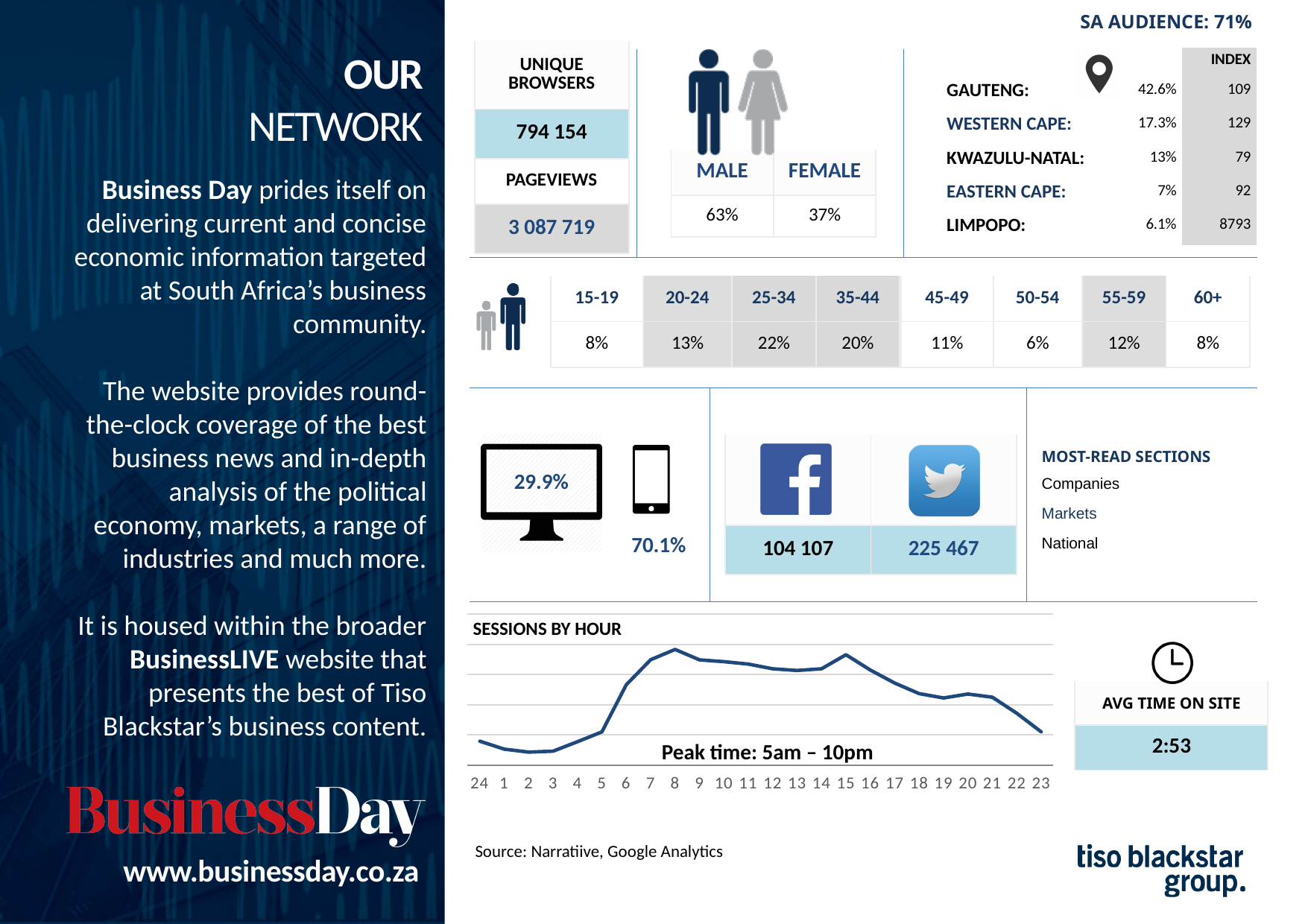
What kind of chart is the "Sessions by Hour" chart? line chart In the "Sessions by Hour" chart, do sessions rise or fall between hour 15 and hour 23? fall In the "Sessions by Hour" chart, which is larger, the value at hour 15 or the value at hour 23? hour 15 In the "Sessions by Hour" chart, which is larger, the value at hour 8 or the value at hour 2? hour 8 In the "Sessions by Hour" chart, which is larger, the value at hour 12 or the value at hour 1? hour 12 How many hour points are plotted along the x axis of the "Sessions by Hour" chart? 24 In the "Sessions by Hour" chart, do sessions rise or fall between hour 3 and hour 8? rise What is the first hour label on the x axis of the "Sessions by Hour" chart? 24 In the "Sessions by Hour" chart, do sessions rise or fall between hour 8 and hour 13? fall What peak time is annotated on the "Sessions by Hour" chart? 5am – 10pm What is the title of the line chart on the slide? SESSIONS BY HOUR